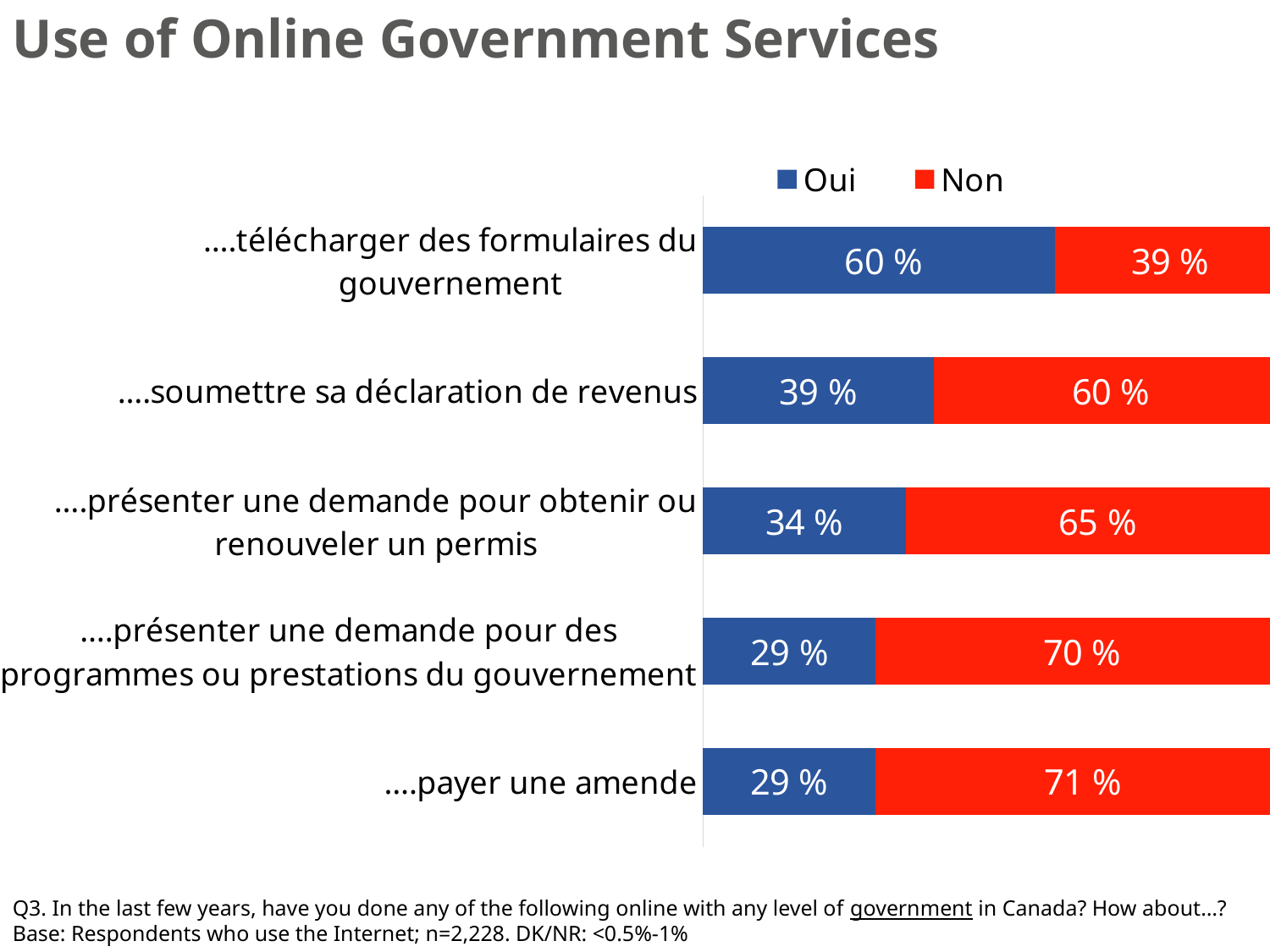
How many series does the legend list? 2 What is the Oui value for "....présenter une demande pour obtenir ou renouveler un permis"? 34 % What is the total of the Oui and Non values for "....présenter une demande pour des programmes ou prestations du gouvernement"? 99 % Which category has the highest Oui value? ....télécharger des formulaires du gouvernement What is the Non value for "....payer une amende"? 71 % How many categories are shown in the chart? 5 Which colour represents the Non series in the chart? Red What percentage of respondents answered Oui for "....télécharger des formulaires du gouvernement"? 60 % What is the difference between the Non value and the Oui value for "....soumettre sa déclaration de revenus"? 21 % Which category has the lowest Non value? ....télécharger des formulaires du gouvernement What kind of chart is shown on the slide? Stacked bar chart Is the Oui value larger for "....soumettre sa déclaration de revenus" or for "....présenter une demande pour des programmes ou prestations du gouvernement"? ....soumettre sa déclaration de revenus